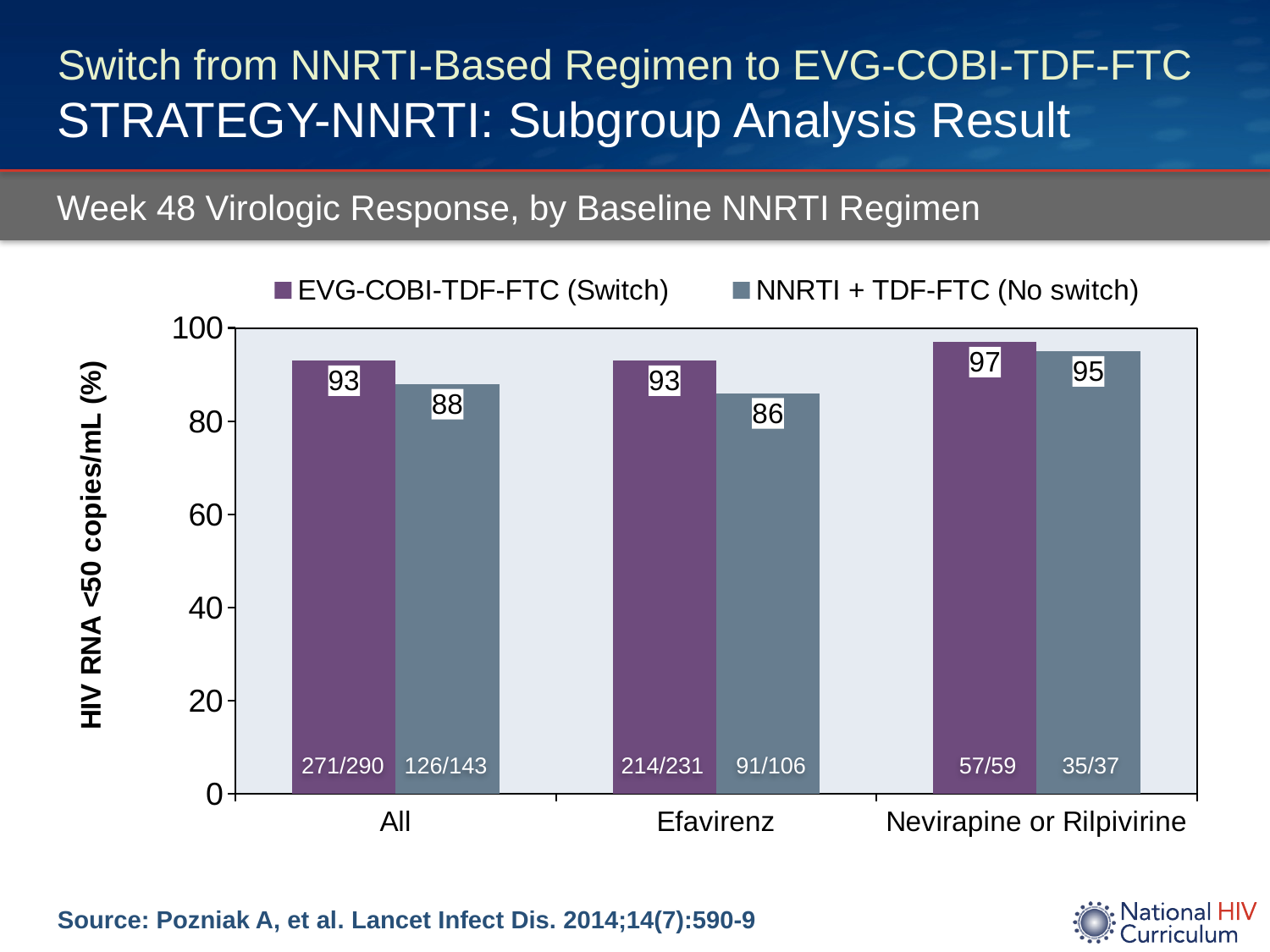
What is the value for NNRTI + TDF-FTC (No switch) in the Efavirenz group? 86 What is the value for NNRTI + TDF-FTC (No switch) in the Nevirapine or Rilpivirine group? 95 In the All group, which series has the larger value, EVG-COBI-TDF-FTC (Switch) or NNRTI + TDF-FTC (No switch)? EVG-COBI-TDF-FTC (Switch) What is the value for EVG-COBI-TDF-FTC (Switch) in the All group? 93 Which category has the lowest value for NNRTI + TDF-FTC (No switch)? Efavirenz Is the value for NNRTI + TDF-FTC (No switch) in the All group greater or less than 80? greater What kind of chart is shown on the slide? Bar chart Which category has the highest value for EVG-COBI-TDF-FTC (Switch)? Nevirapine or Rilpivirine How many categories are shown on the x axis? 3 How many series does the legend list? 2 What is the difference between the EVG-COBI-TDF-FTC (Switch) and NNRTI + TDF-FTC (No switch) values in the Efavirenz group? 7 What is the y-axis label of the chart? HIV RNA <50 copies/mL (%)